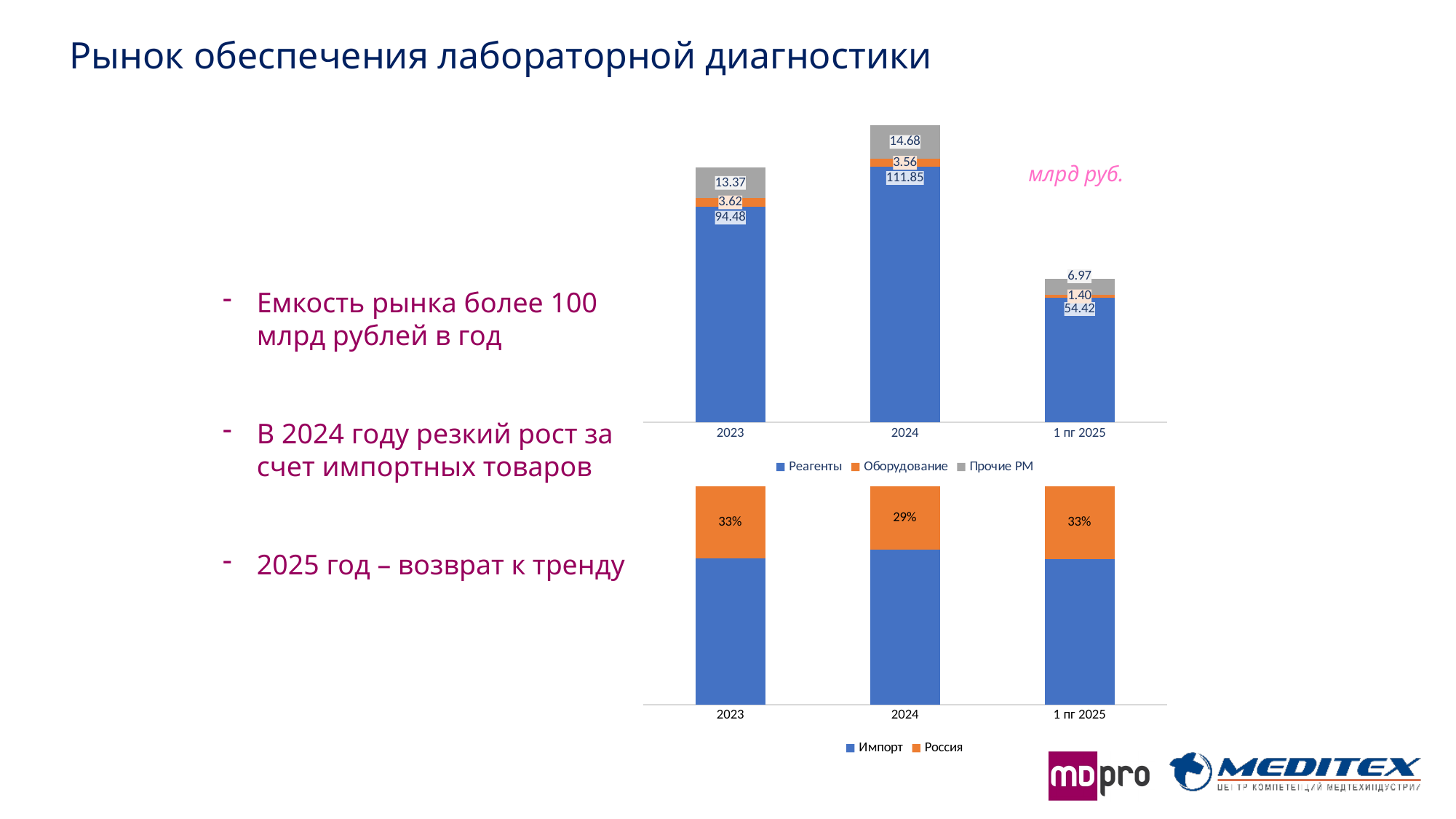
In the top chart, which period has the highest value for Реагенты? 2024 In the top chart, what is the value for Оборудование in 1 пг 2025? 1.40 In the top chart, what is the difference between the Реагенты values for 2024 and 2023? 17.37 In the top chart, what is the total of the stacked bar for 2024? 130.09 How many series does the legend of the top chart list? 3 In the bottom chart, which period has the lowest share for Россия? 2024 In the top chart, what is the value for Реагенты in 2024? 111.85 In the top chart, what is the value for Прочие РМ in 2023? 13.37 In the top chart, which period has the lowest value for Прочие РМ? 1 пг 2025 In the top chart, is the Оборудование value larger in 2023 or in 2024? 2023 What kind of chart is the bottom chart? Stacked bar chart In the bottom chart, what is the share for Россия in 2024? 29%